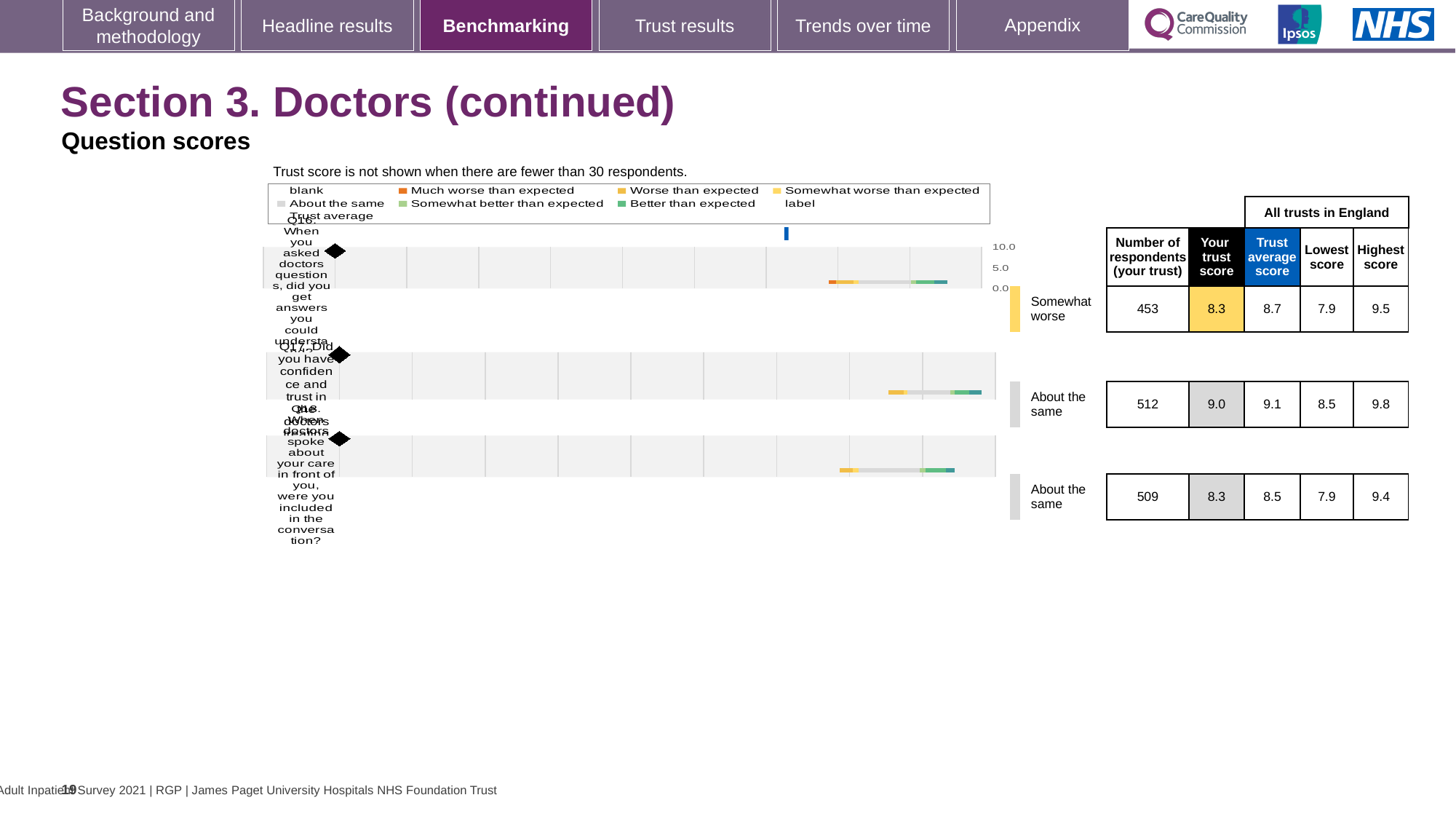
What is the highest score across all trusts in England for Q17? 9.8 Which question has the most respondents from your trust? Q17 Which question has the highest 'Your trust score'? Q17 How many questions are plotted in the chart? 3 What benchmark category is shown for Q16? Somewhat worse What is the 'Your trust score' for Q17 (confidence and trust in the doctors treating you)? 9.0 What is the difference in the number of respondents between Q17 and Q18? 3 For Q17, is your trust score higher or lower than the trust average score? lower How many respondents (your trust) are shown for Q16 (getting answers you could understand from doctors)? 453 What is the difference between the trust average score and your trust score for Q16? 0.4 What kind of chart is used to show the question scores? bar chart What is the lowest score across all trusts in England for Q18 (being included in the conversation when doctors spoke about your care)? 7.9